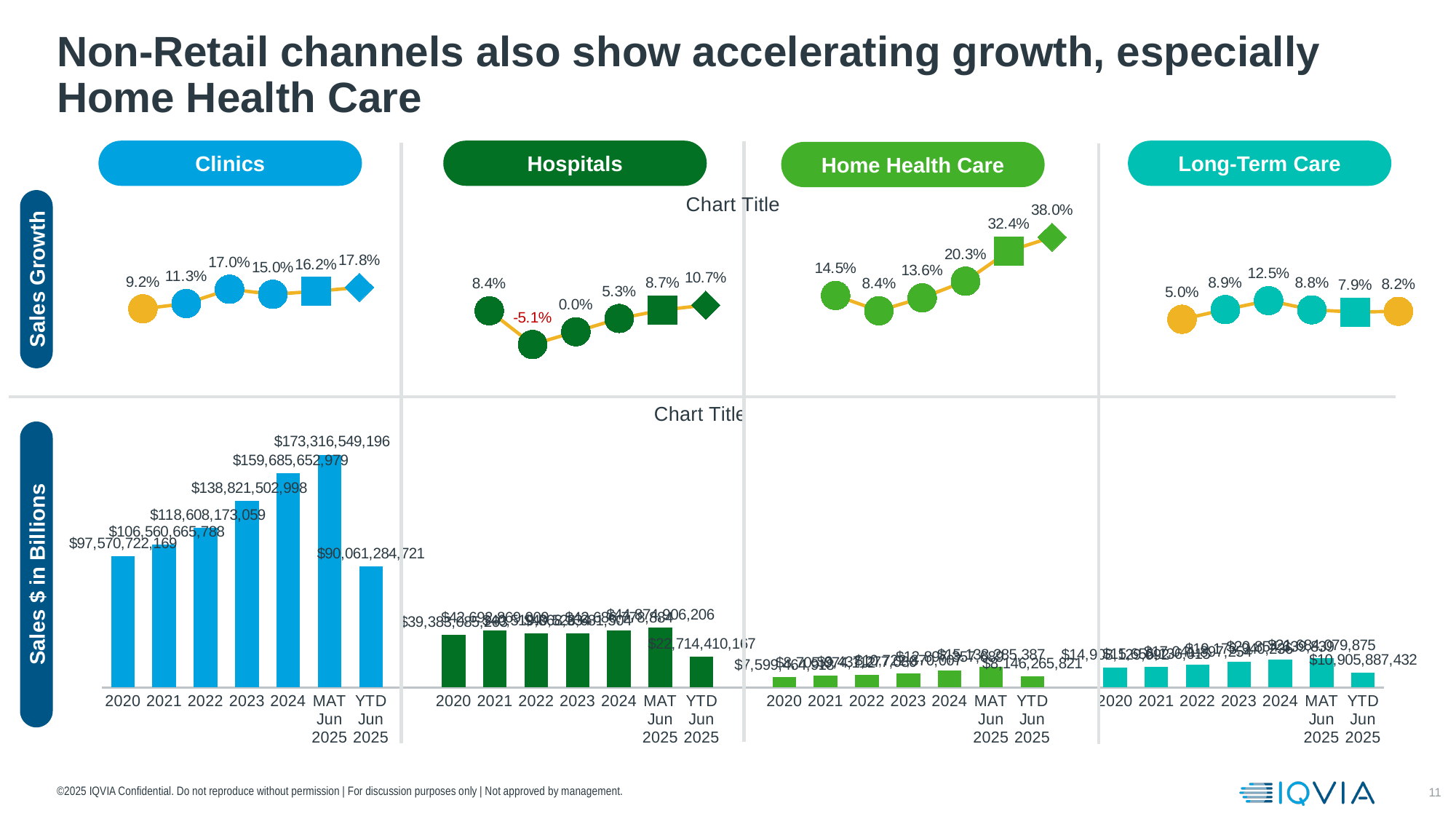
In the Clinics Sales $ in Billions chart, what is the difference between the 2024 value and the 2023 value? $20,864,149,981 In the Clinics Sales $ in Billions chart, which is larger, the value for 2022 or the value for 2021? 2022 In the Long-Term Care Sales Growth chart, what is the highest growth value shown? 12.5% In the Clinics Sales $ in Billions chart, what is the value for MAT Jun 2025? $173,316,549,196 In the Hospitals Sales Growth chart, what is the last (rightmost) growth value shown? 10.7% In the Home Health Care Sales Growth chart, what is the highest growth value shown? 38.0% What kind of chart is the Clinics Sales $ in Billions chart? bar chart What kind of chart is the Clinics Sales Growth chart? line chart In the Hospitals Sales Growth chart, what is the lowest growth value shown? -5.1% How many categories are shown on the x axis of the Clinics Sales $ in Billions chart? 7 In the Hospitals Sales $ in Billions chart, what is the value for YTD Jun 2025? $22,714,410,167 In the Clinics Sales $ in Billions chart, what is the value for 2020? $97,570,722,169